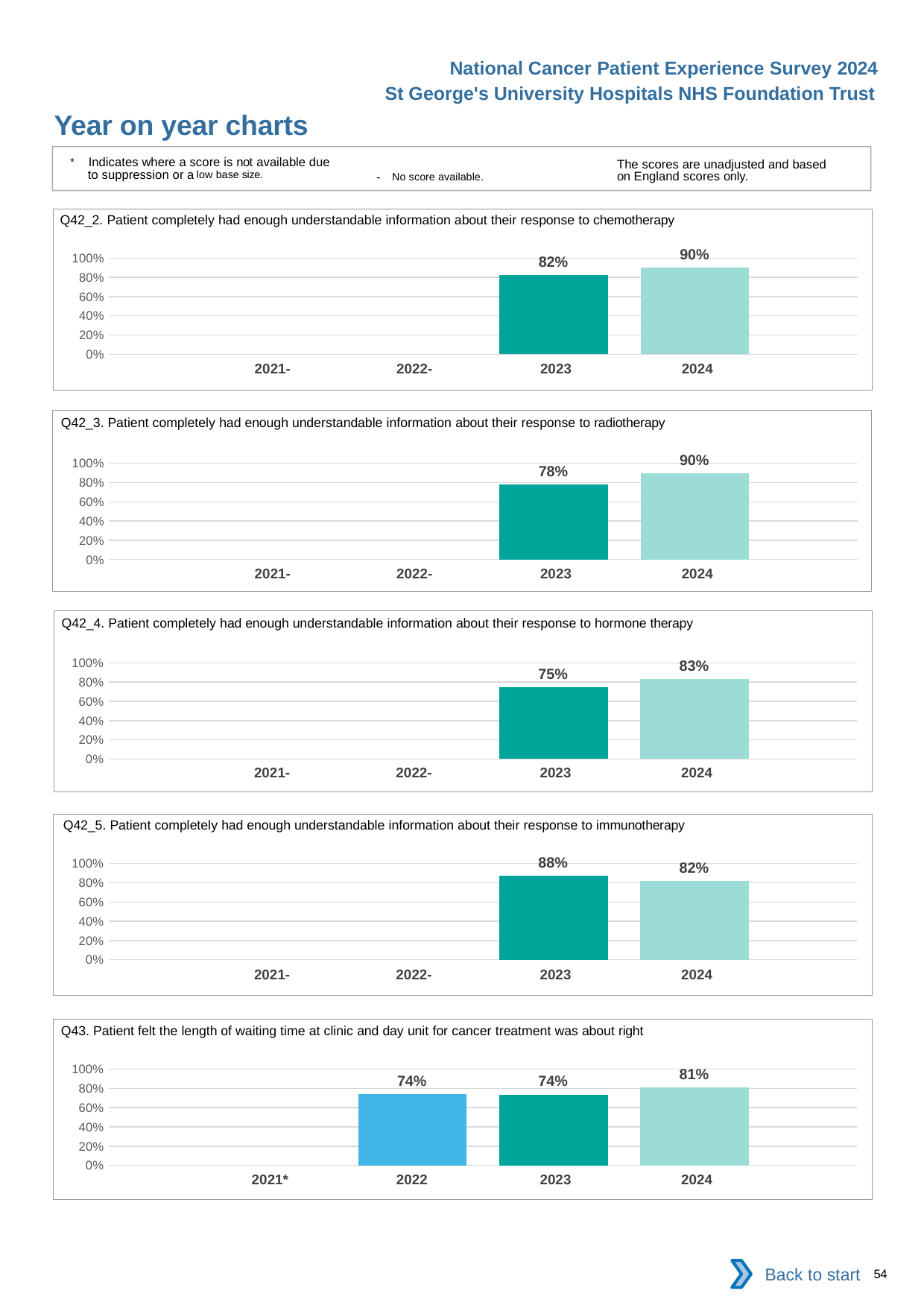
In the Q42_4 chart (hormone therapy), what is the difference between the 2024 and 2023 values? 8% In the Q43 chart, which year label is marked with an asterisk? 2021* In the Q42_5 chart (immunotherapy), which year has the higher value, 2023 or 2024? 2023 In the Q42_3 chart (radiotherapy), what is the value for 2023? 78% In the Q42_2 chart (chemotherapy), what is the difference between the 2024 and 2023 values? 8% In the Q42_2 chart (chemotherapy), what is the value for 2024? 90% In the Q43 chart (waiting time at clinic and day unit), which year has the highest value? 2024 What kind of chart is the Q42_2 chart (chemotherapy)? bar chart In the Q43 chart (waiting time at clinic and day unit), how many bars are plotted? 3 In the Q43 chart (waiting time at clinic and day unit), what is the value for 2022? 74% In the Q42_3 chart (radiotherapy), do the values rise or fall from 2023 to 2024? rise In the Q42_5 chart (immunotherapy), is the value for 2024 greater or less than 80%? greater